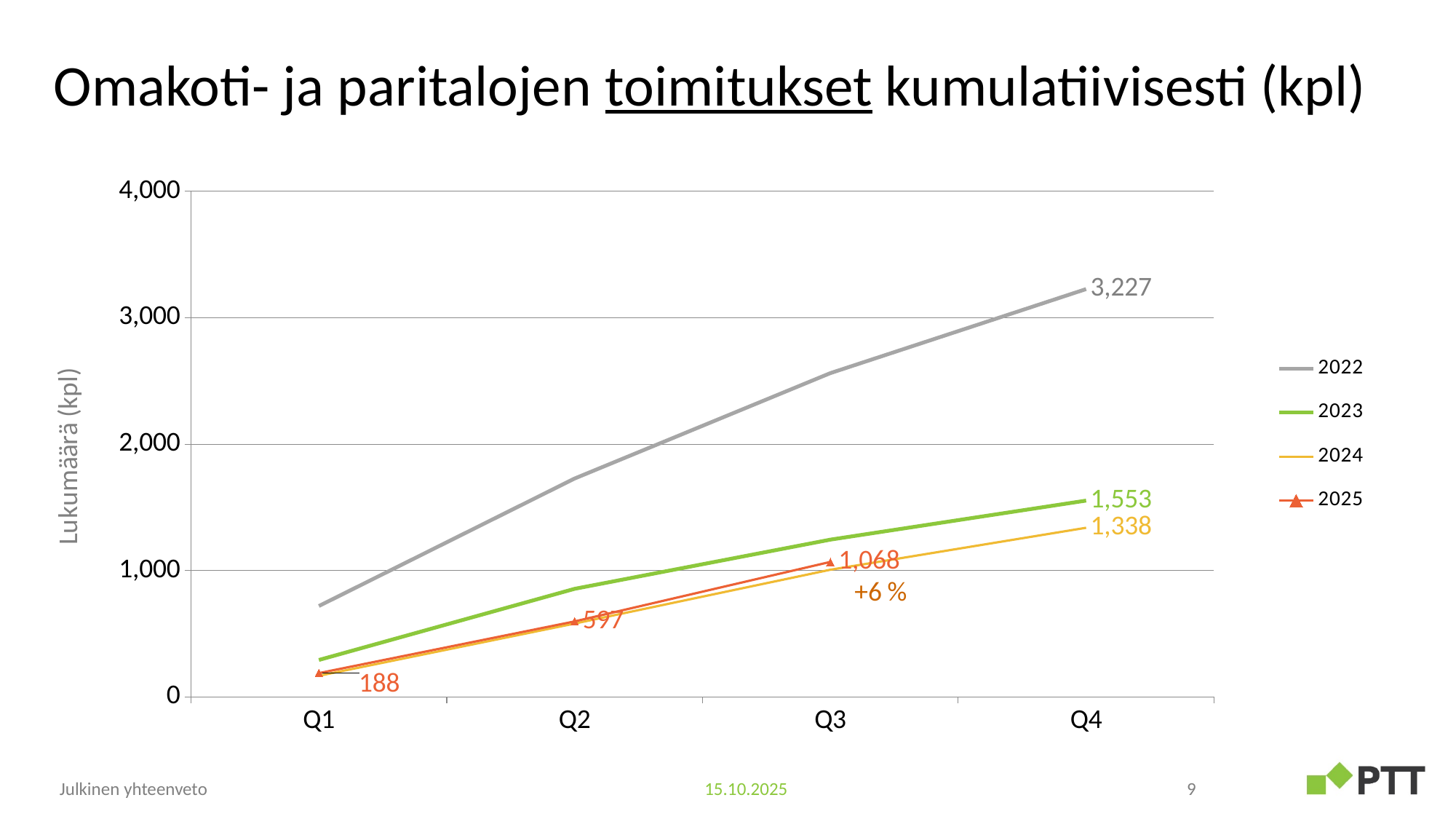
What is the value for 2022 at Q4? 3,227 Do the values for 2025 rise or fall from Q1 to Q3? rise What is the difference between the 2023 and 2024 values at Q4? 215 What is the value for 2024 at Q4? 1,338 Is the value for 2022 at Q2 greater or less than 1,000? greater What is the value for 2023 at Q4? 1,553 What kind of chart is shown on the slide? line chart How many series does the legend list? 4 What is the value for 2025 at Q1? 188 What is the value for 2025 at Q3? 1,068 Which series has the highest value at Q4? 2022 What is the y-axis title of the chart? Lukumäärä (kpl)